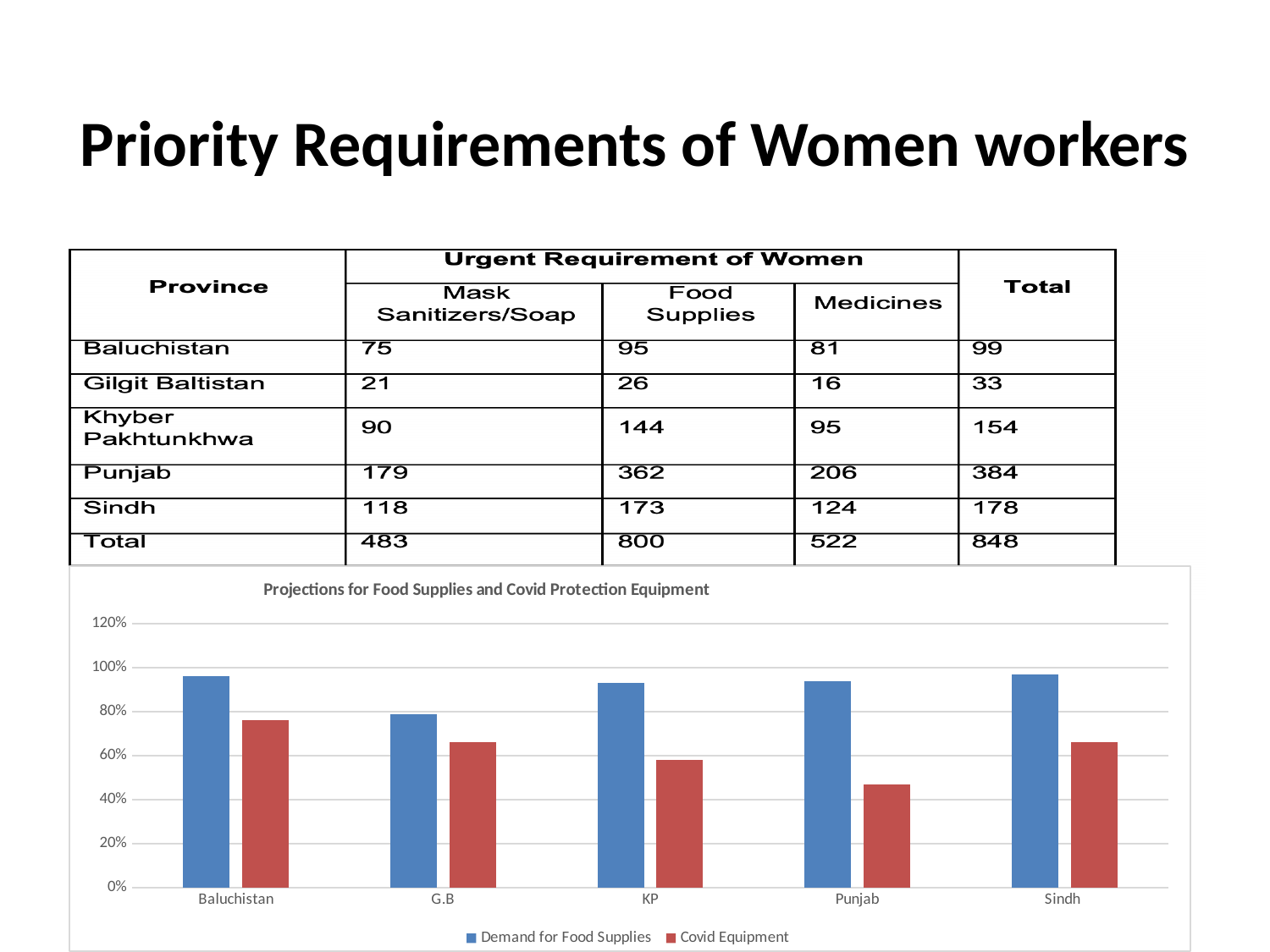
Which province has the lowest value for Demand for Food Supplies? G.B Is the Covid Equipment value for KP greater or less than 80%? less What kind of chart is shown on the slide? bar chart Which province has the lowest value for Covid Equipment? Punjab How many series does the chart's legend list? 2 Is the Demand for Food Supplies value for Baluchistan greater or less than 80%? greater How many provinces are shown on the x axis of the chart? 5 What is the title of the chart on the slide? Projections for Food Supplies and Covid Protection Equipment Which province has the highest value for Covid Equipment? Baluchistan For Baluchistan, which is larger: Demand for Food Supplies or Covid Equipment? Demand for Food Supplies Is the Covid Equipment value for Punjab greater or less than 60%? less Which colour represents Covid Equipment in the chart? red